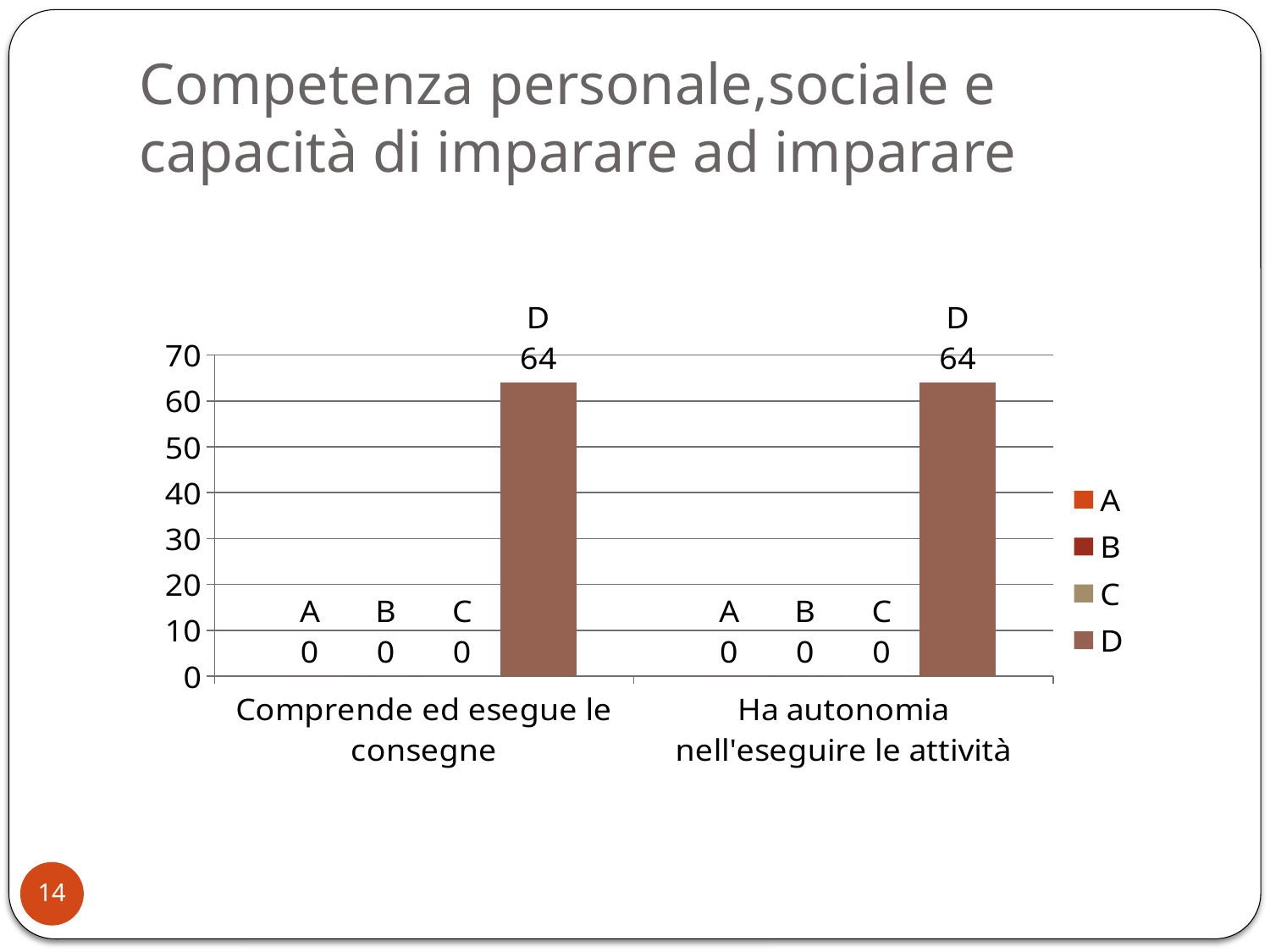
How many series does the legend list? 4 Is the value of series D for "Comprende ed esegue le consegne" greater or less than 60? greater Which series has the highest value for "Ha autonomia nell'eseguire le attività"? D How many categories are shown on the x axis? 2 What is the value of series A for "Comprende ed esegue le consegne"? 0 What is the difference between the D value and the B value for "Comprende ed esegue le consegne"? 64 What is the value of series C for "Ha autonomia nell'eseguire le attività"? 0 What is the value of series D for "Ha autonomia nell'eseguire le attività"? 64 What kind of chart is shown on the slide? bar chart What is the title of the slide? Competenza personale,sociale e capacità di imparare ad imparare What is the total of the values for A, B, C and D for "Ha autonomia nell'eseguire le attività"? 64 What is the value of series D for "Comprende ed esegue le consegne"? 64